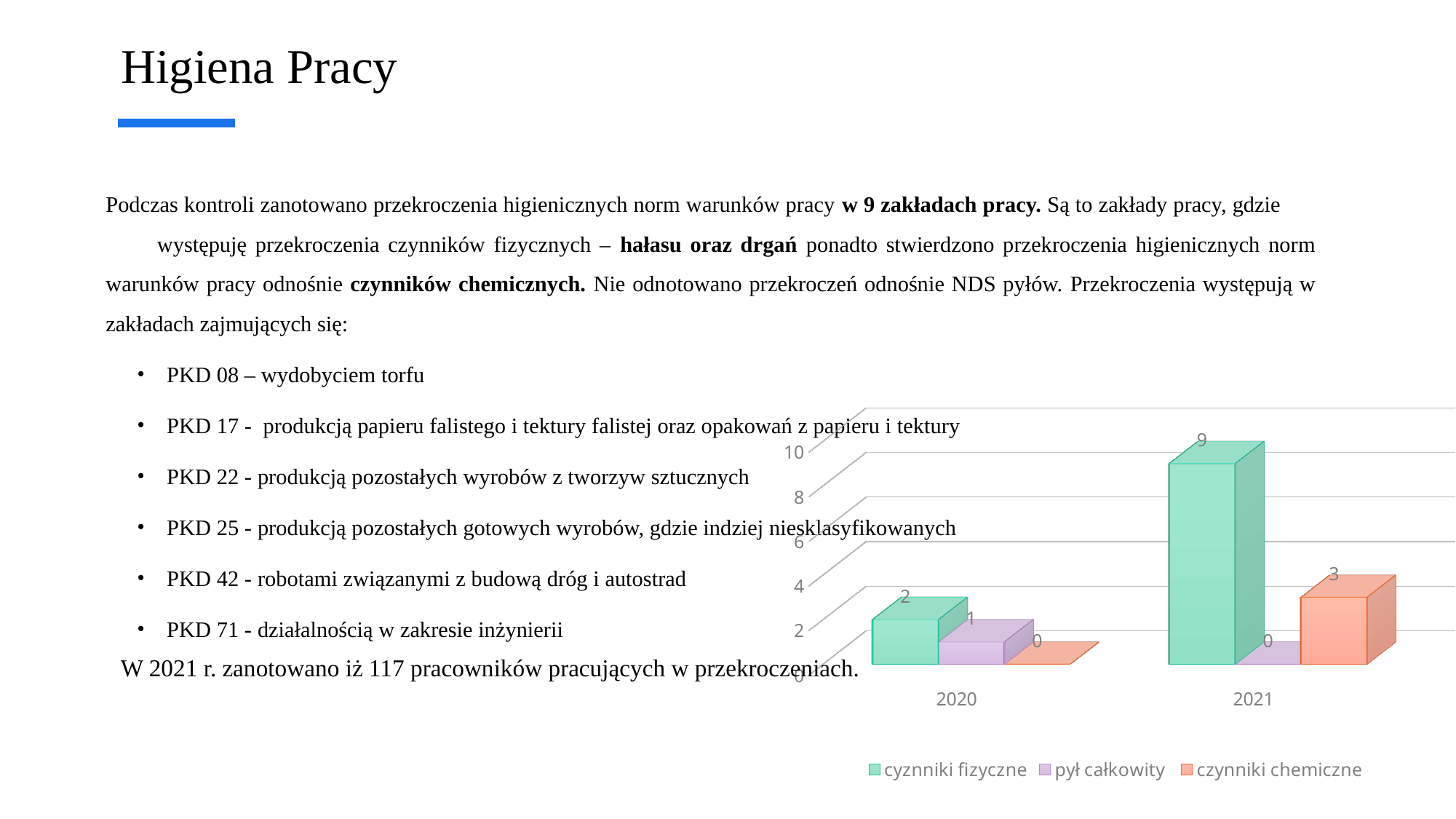
Which series has the highest value in 2021? cyznniki fizyczne Which is larger: czynniki chemiczne in 2021 or cyznniki fizyczne in 2020? czynniki chemiczne in 2021 Which series has the lowest value in 2021? pył całkowity How many year categories are shown on the x axis? 2 What kind of chart is shown on the slide? bar chart What is the value for cyznniki fizyczne in 2021? 9 What is the value for czynniki chemiczne in 2021? 3 What is the value for pył całkowity in 2020? 1 What is the difference between the cyznniki fizyczne values for 2021 and 2020? 7 Does the value for cyznniki fizyczne rise or fall from 2020 to 2021? rise What is the value for czynniki chemiczne in 2020? 0 How many series does the legend list? 3